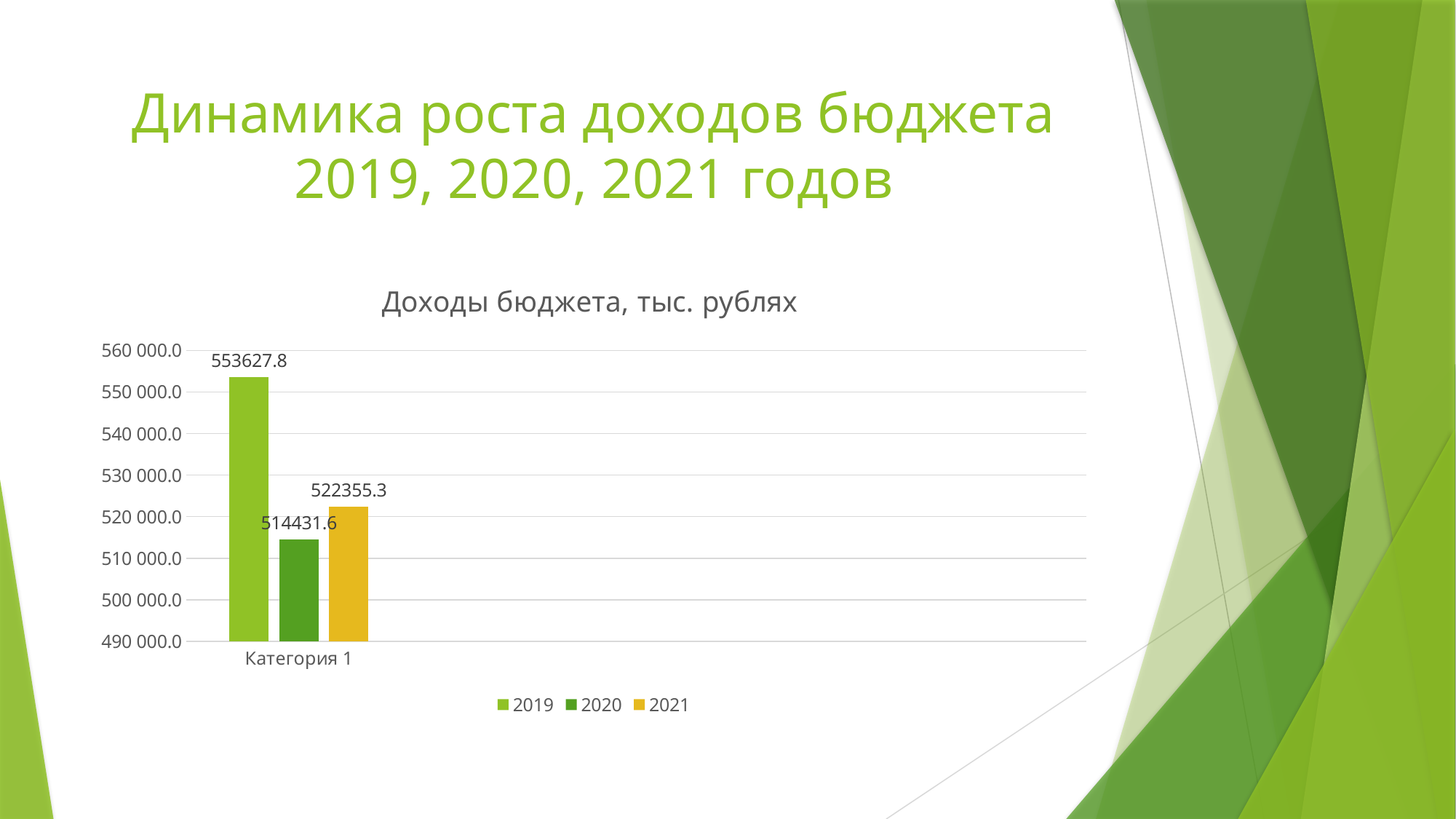
Which series has the highest value in the chart? 2019 What is the difference between the 2019 value and the 2020 value? 39196.2 What is the value for the 2019 series in the chart? 553627.8 What is the difference between the 2021 value and the 2020 value? 7923.7 Which is larger, the value for 2021 or the value for 2020? 2021 Which series has the lowest value in the chart? 2020 What is the value for the 2021 series in the chart? 522355.3 How many series does the legend list? 3 What is the title of the chart? Доходы бюджета, тыс. рублях Is the value for 2020 greater or less than 520 000.0? less What kind of chart is shown on the slide? bar chart What is the value for the 2020 series in the chart? 514431.6